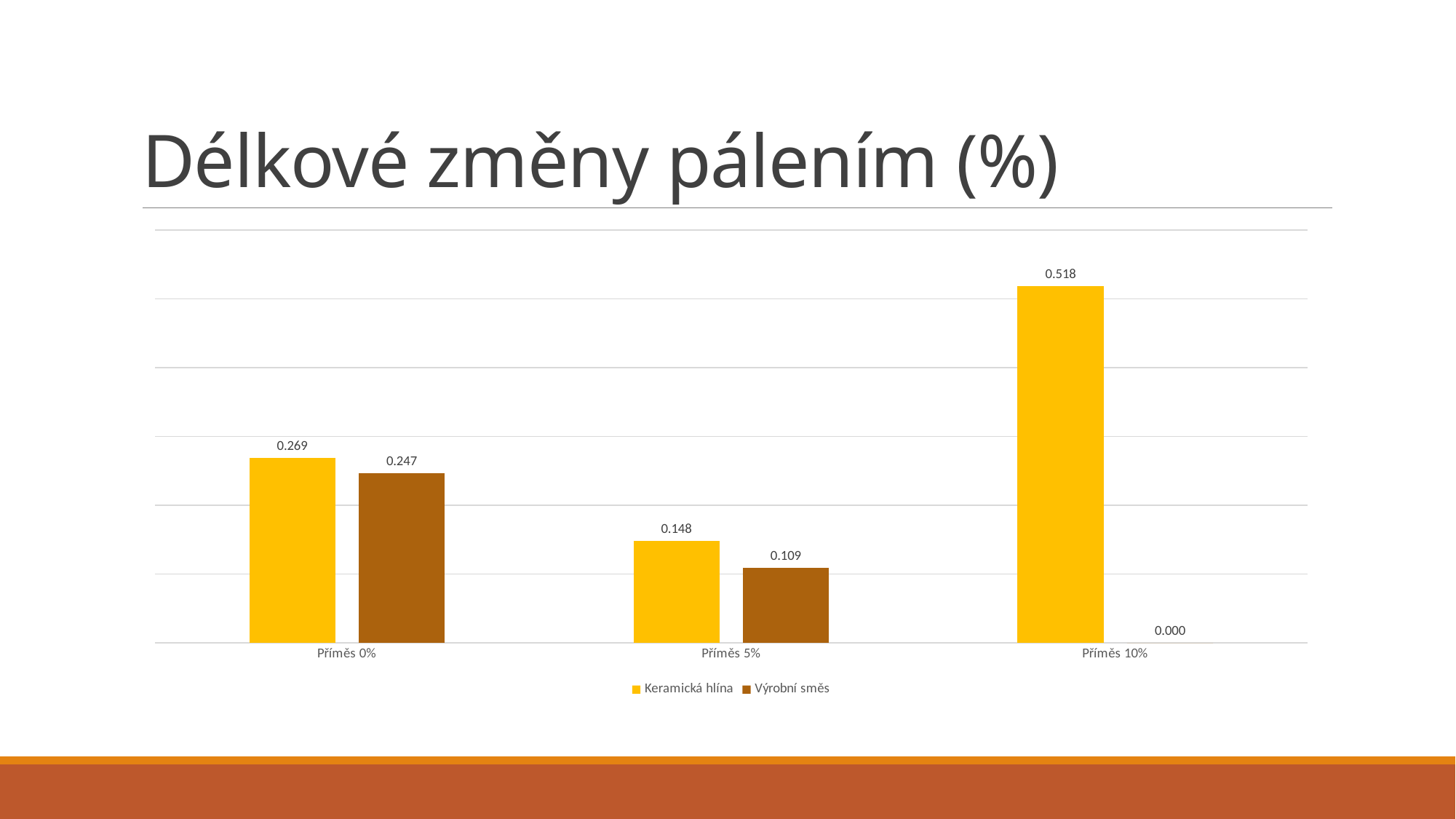
What is the value for Výrobní směs at Příměs 5%? 0.109 What is the value for Výrobní směs at Příměs 10%? 0.000 What kind of chart is shown on the slide? Bar chart How many categories are shown on the x axis? 3 How many series does the legend list? 2 Which category has the lowest value for Výrobní směs? Příměs 10% Which category has the highest value for Keramická hlína? Příměs 10% What is the difference between Keramická hlína and Výrobní směs at Příměs 0%? 0.022 What is the title of the slide? Délkové změny pálením (%) What is the value for Keramická hlína at Příměs 10%? 0.518 Which is larger at Příměs 5%: Keramická hlína or Výrobní směs? Keramická hlína What is the value for Keramická hlína at Příměs 0%? 0.269